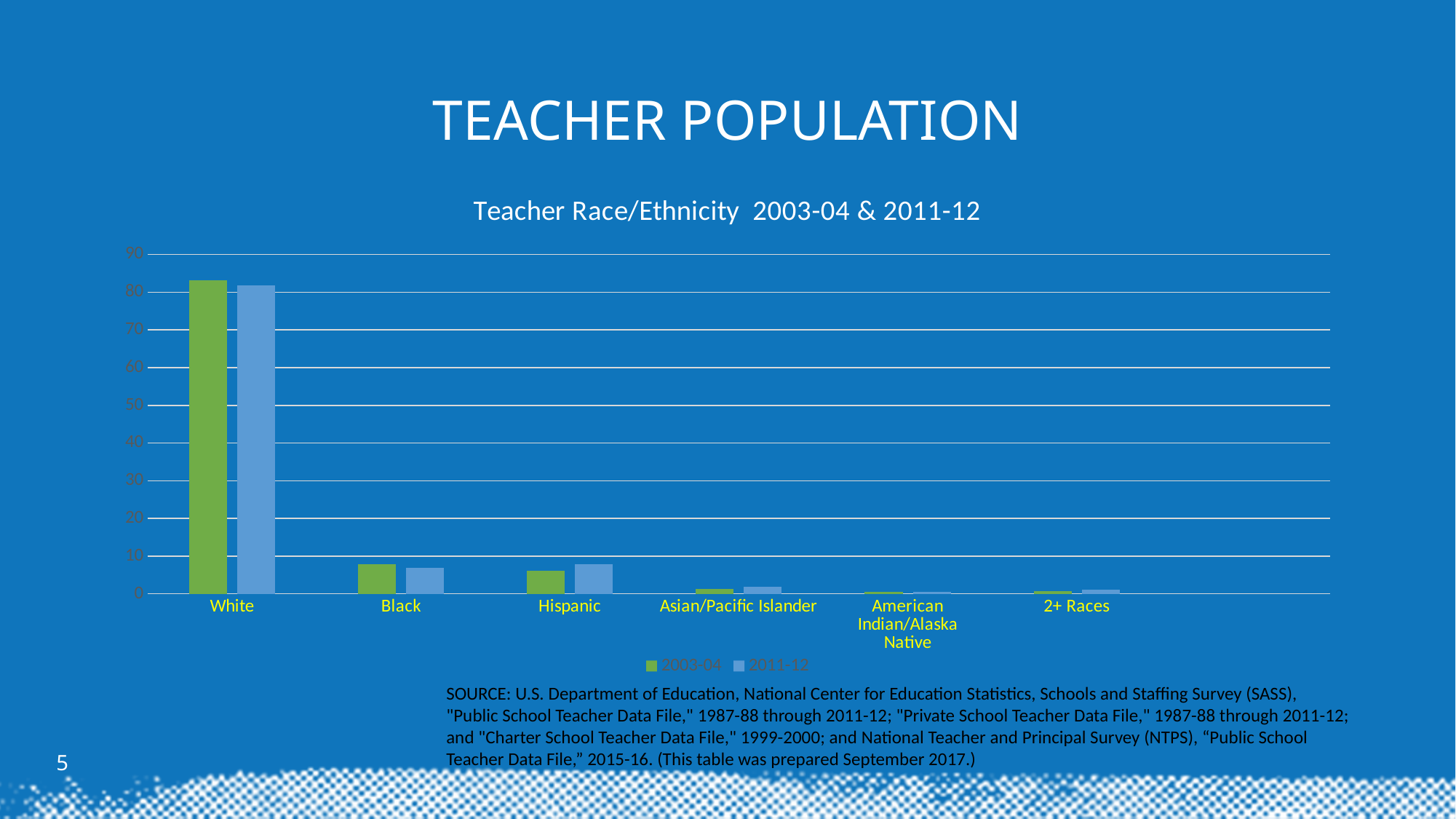
Which category has the highest value in the 2003-04 series? White For Hispanic, which series has the larger value, 2003-04 or 2011-12? 2011-12 Is the 2011-12 value for Black greater or less than 10? less What is the title of the chart? Teacher Race/Ethnicity 2003-04 & 2011-12 Is the 2003-04 value for White greater or less than 80? greater In the 2003-04 series, which is larger, Black or Hispanic? Black Which category has the highest value in the 2011-12 series? White Which colour represents the 2003-04 series? green How many race/ethnicity categories are shown on the x axis? 6 How many series does the legend list? 2 Is the 2003-04 value for Hispanic greater or less than 10? less What kind of chart is shown on the slide? bar chart